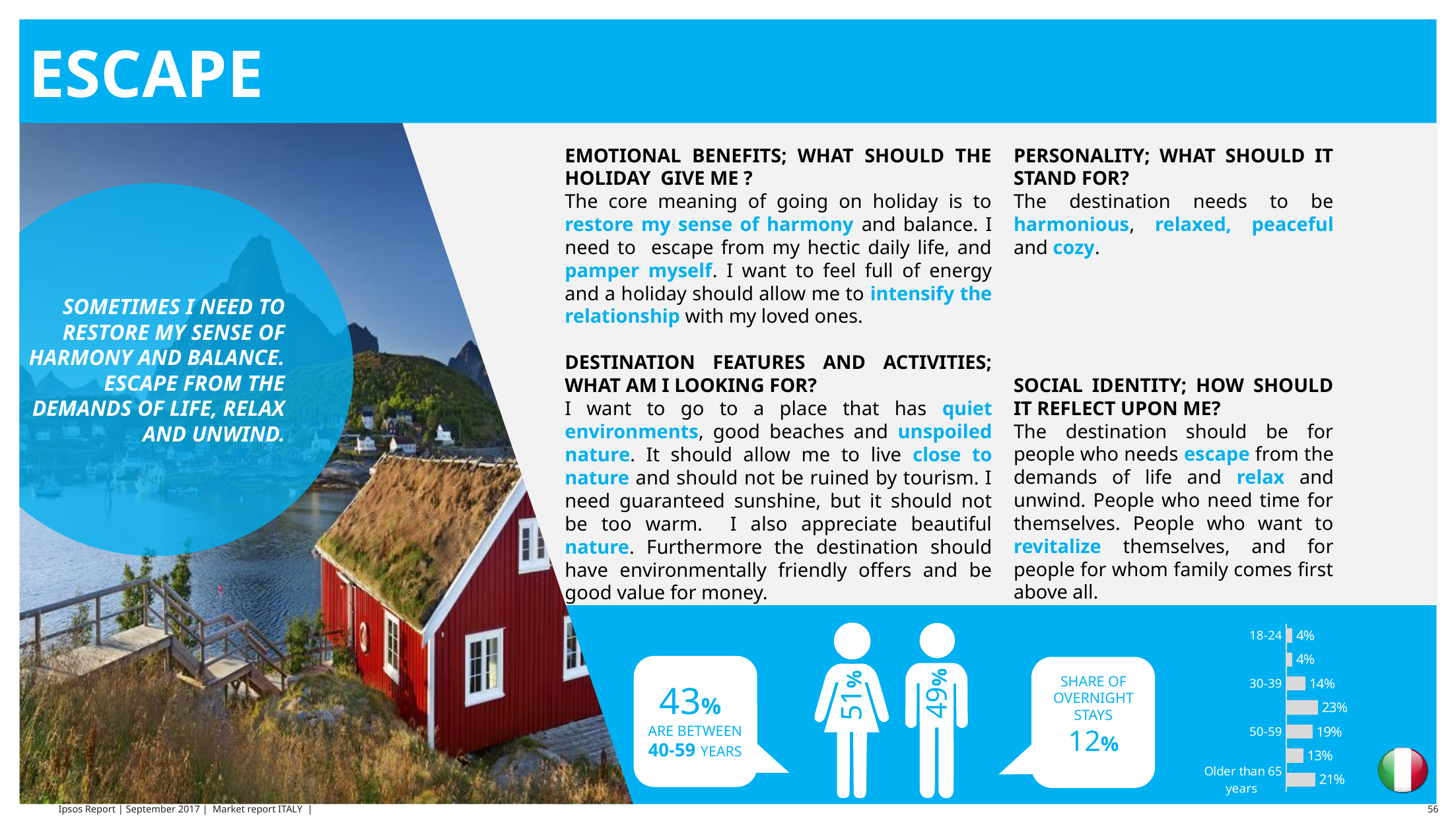
In the bar chart at the bottom right, what is the value for the 'Older than 65 years' group? 21% In the bar chart at the bottom right, what is the value for the 50-59 age group? 19% In the bar chart at the bottom right, what is the value for the 30-39 age group? 14% What kind of chart is shown at the bottom right of the slide? bar chart In the bar chart at the bottom right, what is the value for the 18-24 age group? 4% In the bar chart at the bottom right, which is larger: the value for 50-59 or the value for 30-39? 50-59 In the bar chart at the bottom right, what is the difference between the values for 50-59 and 30-39? 5 percentage points In the bar chart at the bottom right, what is the highest data label shown on any bar? 23% In the bar chart at the bottom right, what is the difference between the values for 'Older than 65 years' and 18-24? 17 percentage points How many bars are plotted in the bar chart at the bottom right of the slide? 7 In the bar chart at the bottom right, which of the labelled age groups (18-24, 30-39, 50-59, Older than 65 years) has the highest value? Older than 65 years In the bar chart at the bottom right, which of the labelled age groups (18-24, 30-39, 50-59, Older than 65 years) has the lowest value? 18-24